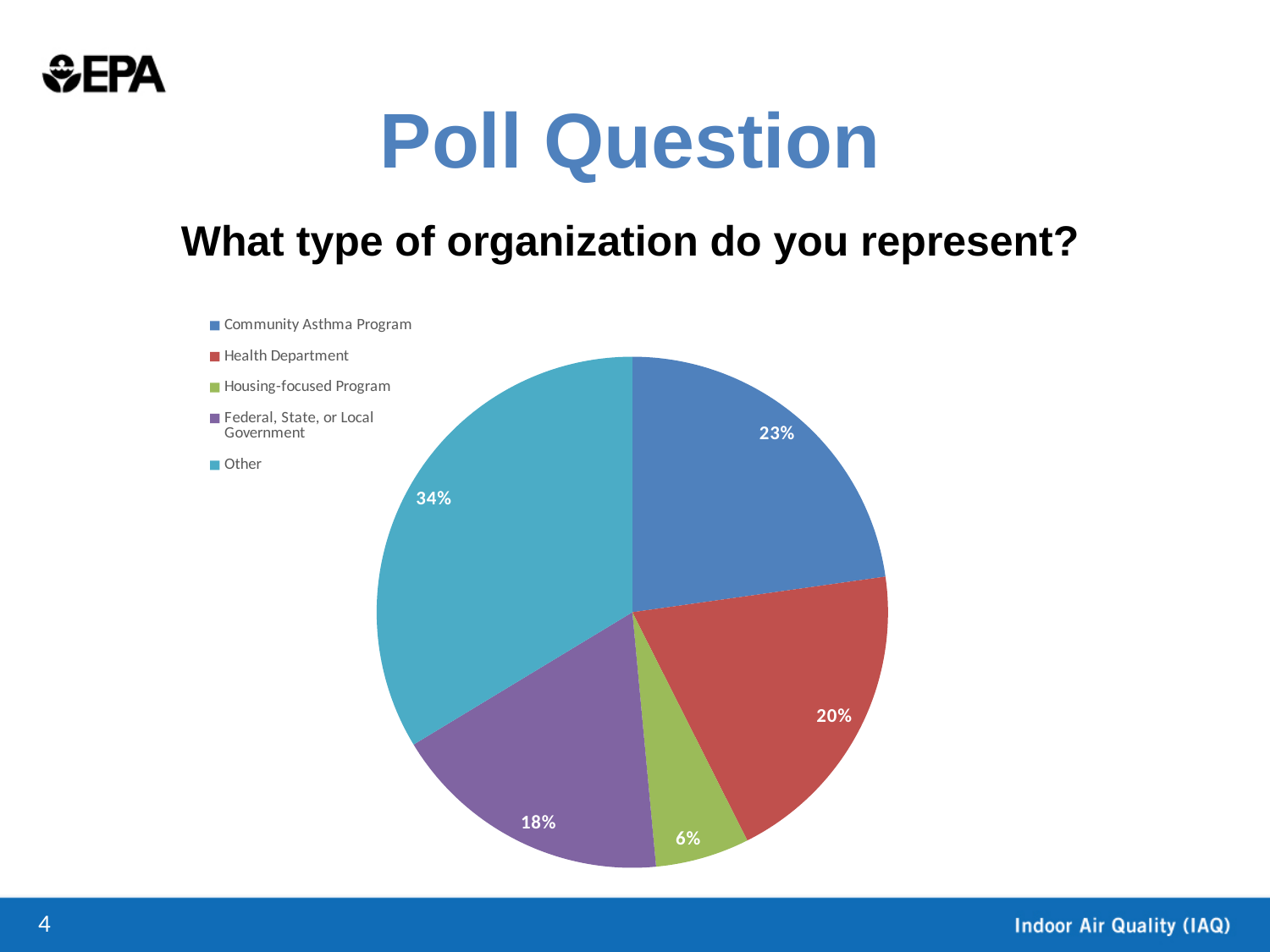
What share of the pie is Housing-focused Program? 6% Which category has the smallest slice of the pie? Housing-focused Program What is the difference between the Other share and the Community Asthma Program share? 11% What share of the pie is Health Department? 20% How many categories does the pie chart have? 5 What share of the pie is Community Asthma Program? 23% What colour is the Housing-focused Program slice? green Which category has the largest slice of the pie? Other Which is larger, the Health Department share or the Federal, State, or Local Government share? Health Department What kind of chart is shown on the slide? pie chart